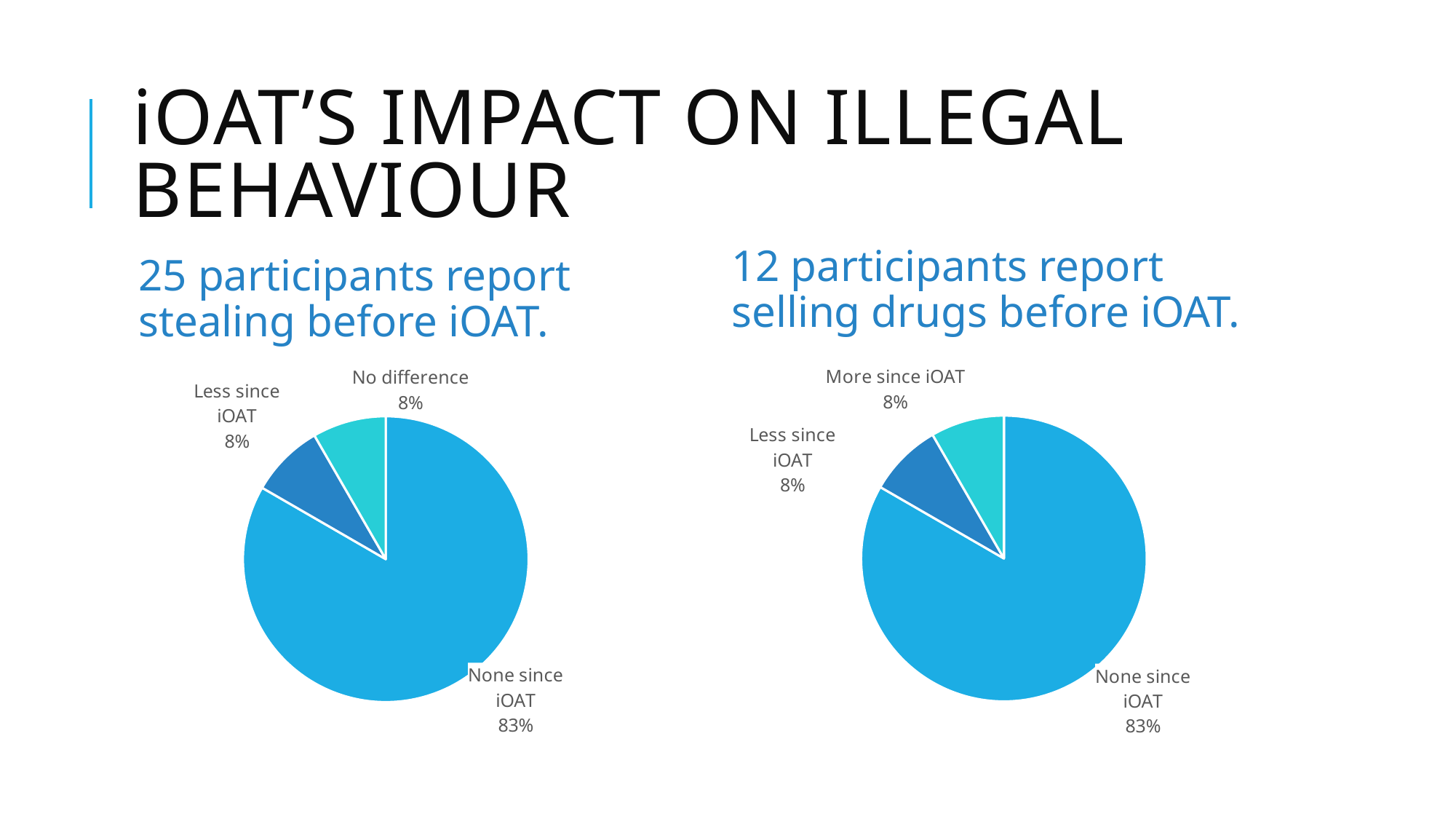
In the right pie chart (selling drugs before iOAT), what share is labelled 'More since iOAT'? 8% In the left pie chart (stealing before iOAT), what is the difference between the 'None since iOAT' share and the 'Less since iOAT' share? 75% In the right pie chart (selling drugs before iOAT), is the 'None since iOAT' slice larger or smaller than the 'More since iOAT' slice? Larger In the left pie chart (stealing before iOAT), what share is labelled 'No difference'? 8% How many participants does the slide say reported selling drugs before iOAT? 12 What type of chart is used on the left of the slide? Pie chart In the right pie chart (selling drugs before iOAT), which category has the largest slice? None since iOAT In the left pie chart (stealing before iOAT), what share is labelled 'None since iOAT'? 83% In the left pie chart (stealing before iOAT), which category has the largest slice? None since iOAT In the left pie chart (stealing before iOAT), how many slices are there? 3 In the right pie chart (selling drugs before iOAT), how many slices are there? 3 In the right pie chart (selling drugs before iOAT), what share is labelled 'Less since iOAT'? 8%